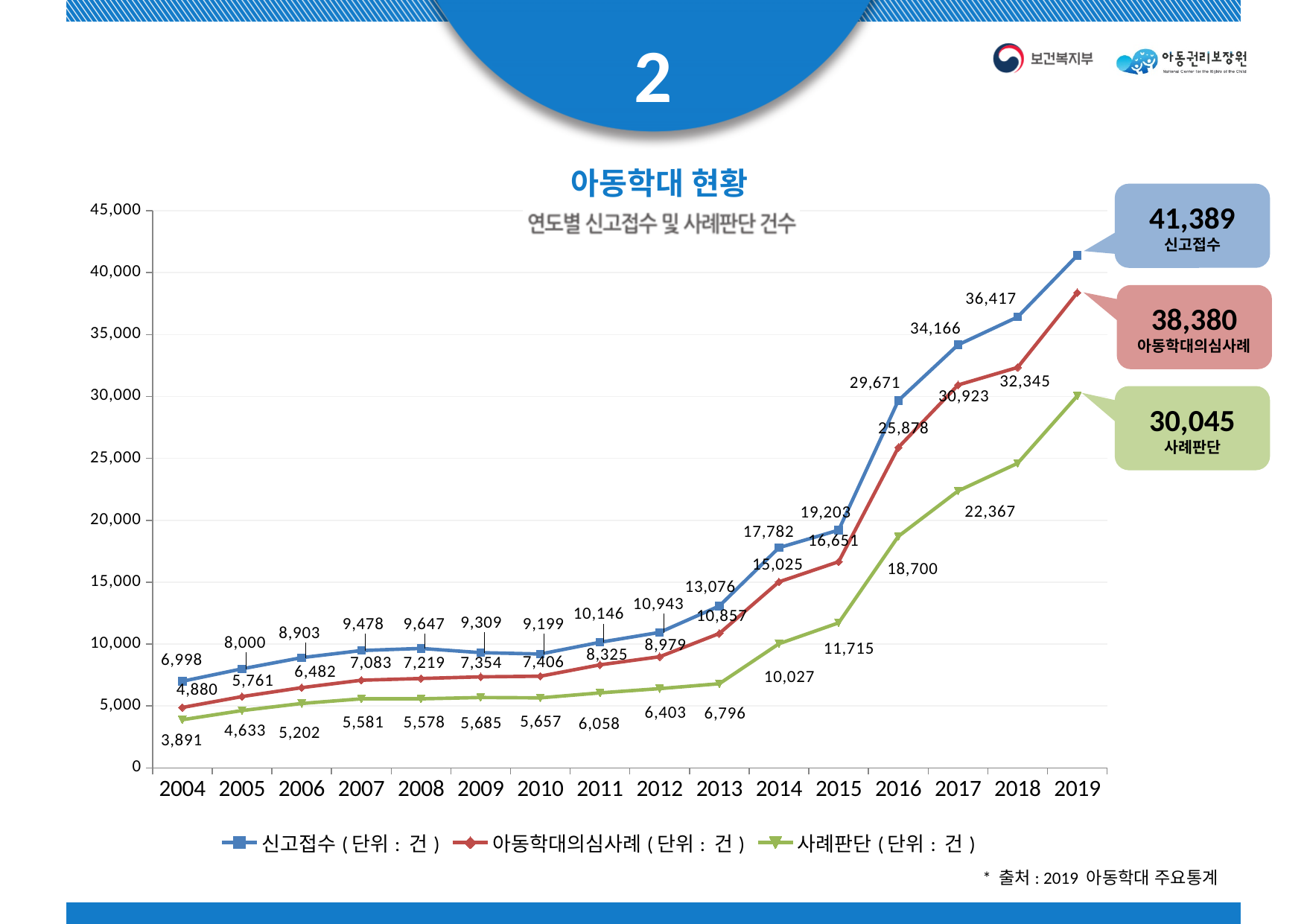
What is the difference between 신고접수 and 아동학대의심사례 in 2019? 3,009 Which is larger in 2013: 신고접수 or 사례판단? 신고접수 Does 아동학대의심사례 generally rise or fall from 2004 to 2019? rise How many years are shown on the x axis? 16 How many series does the legend list? 3 What is the value of 아동학대의심사례 in 2016? 25,878 What is the value of 사례판단 in 2014? 10,027 In which year is 사례판단 lowest? 2004 Is the value of 사례판단 in 2018 greater or less than 20,000? greater What type of chart is shown on the slide? line chart What is the value of 신고접수 in 2019? 41,389 In which year is 신고접수 highest? 2019